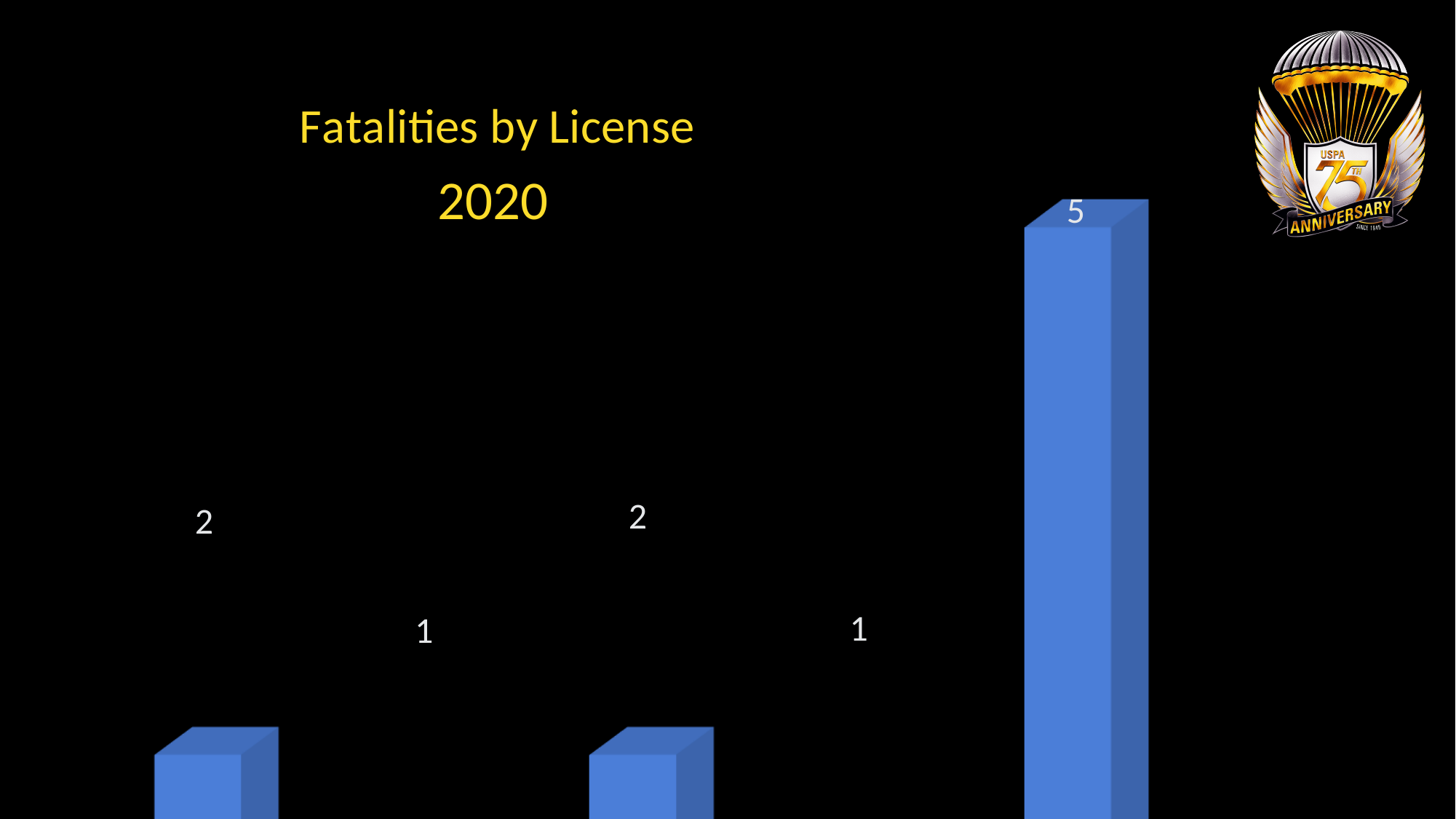
What kind of chart is shown on the slide? bar chart What is the lowest value shown in the chart? 1 How many data labels (categories) are shown in the chart? 5 What is the value of the leftmost bar in the chart? 2 What is the sum of all the values shown in the chart? 11 Is the rightmost bar's value larger or smaller than the leftmost bar's value? larger What is the highest value shown in the chart? 5 What is the value of the tallest (rightmost) bar in the chart? 5 What is the title of the chart? Fatalities by License 2020 How many of the data labels in the chart show the value 2? 2 What colour are the bars in the chart? blue What is the difference between the highest value (5) and the lowest value (1) in the chart? 4